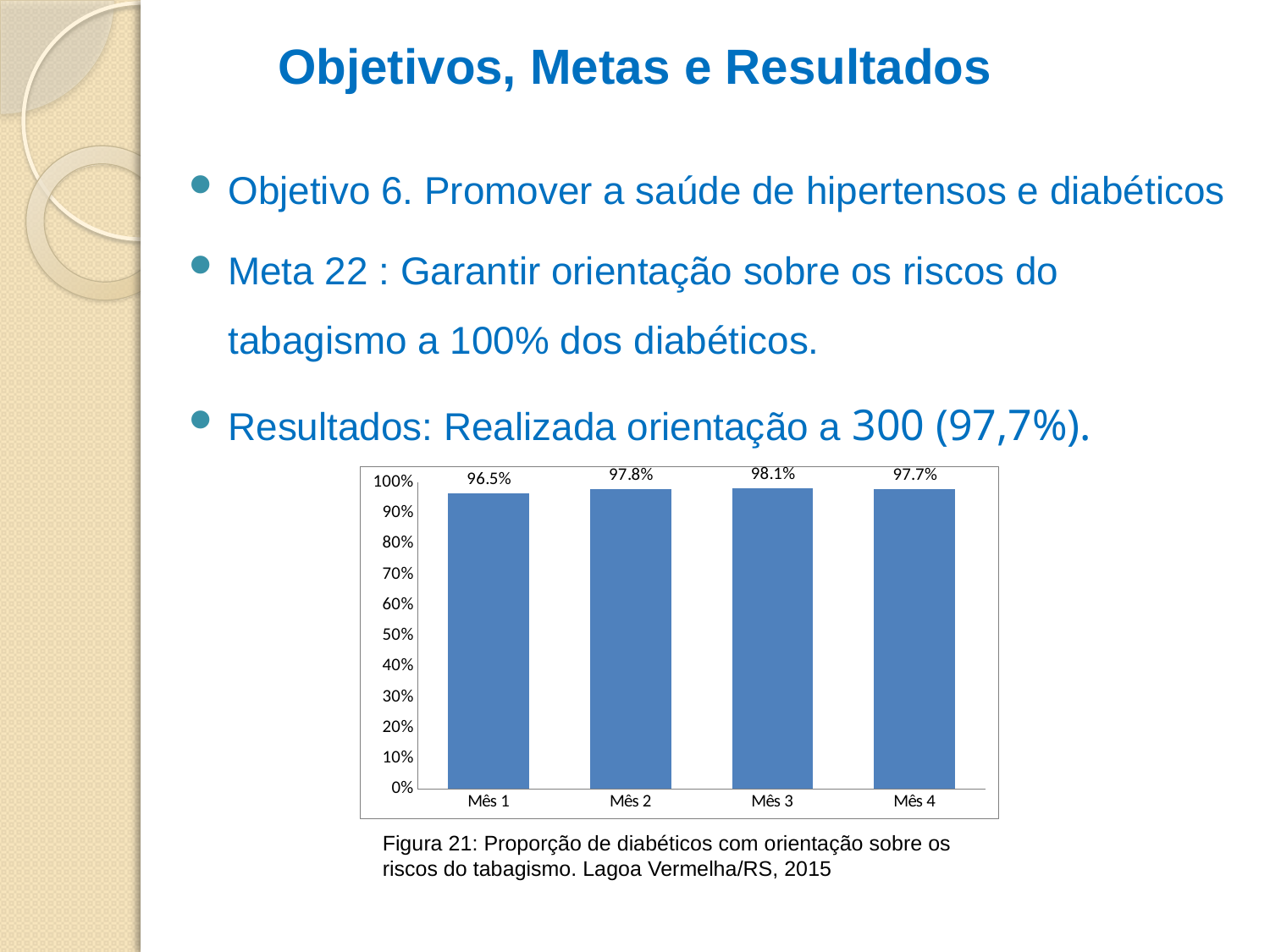
Which month has the lowest value? Mês 1 What kind of chart is shown on the slide? bar chart Do the values rise or fall from Mês 1 to Mês 3? rise Which month has the highest value according to the data labels? Mês 3 Which is larger, the value for Mês 1 or the value for Mês 3? Mês 3 What is the difference between the values for Mês 3 and Mês 1? 1.6% How many months are shown on the x axis? 4 Is the value for Mês 1 greater or less than 90%? greater What is the value for Mês 4? 97.7% What is the value for Mês 3? 98.1% What is the value for Mês 2? 97.8% What is the value for Mês 1? 96.5%